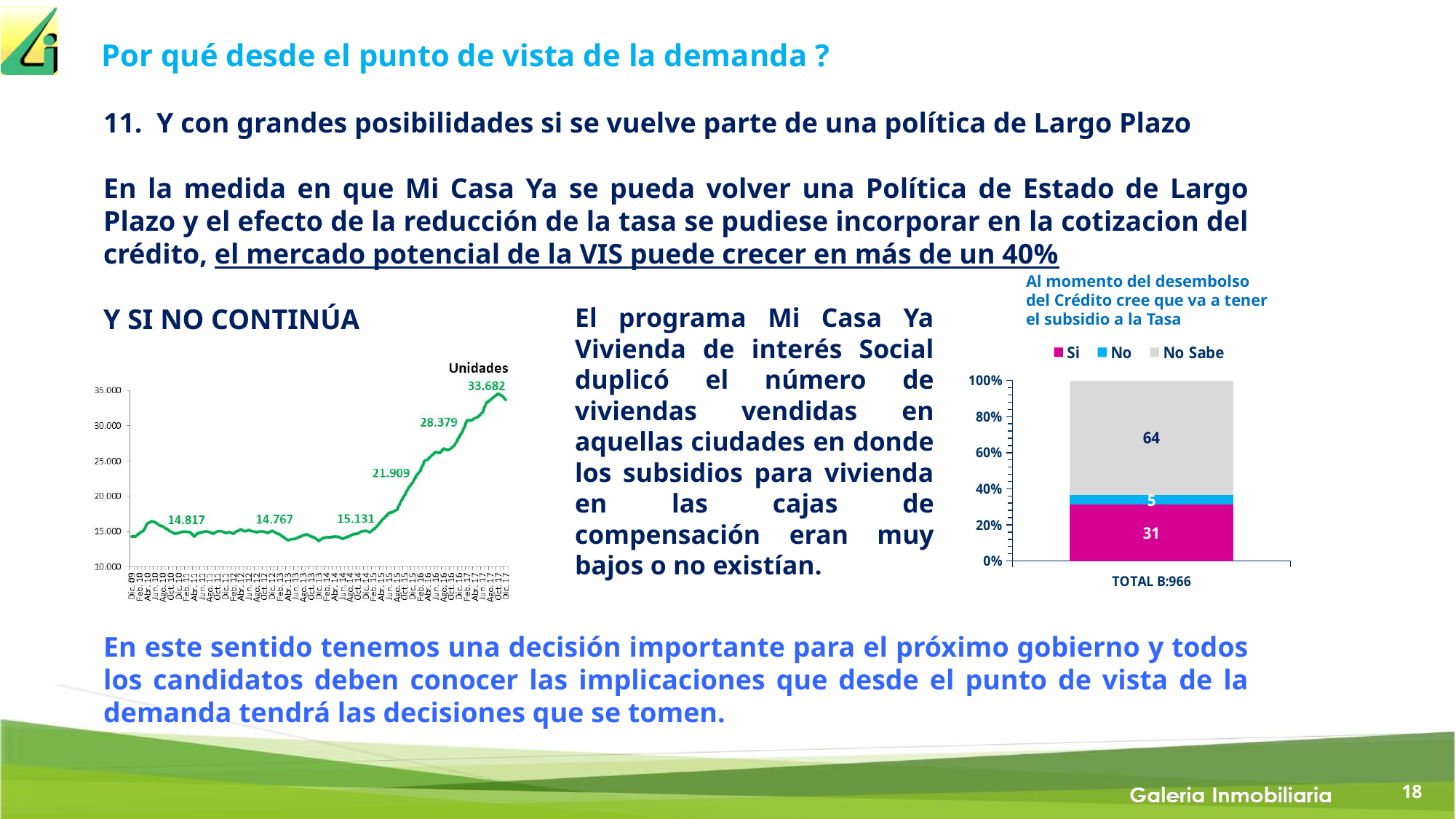
On the "Unidades" line chart, does the series rise or fall over the final years of the x axis? Rise On the stacked bar chart on the right, which response has the smallest share? No On the stacked bar chart on the right, which response has the largest share? No Sabe On the stacked bar chart on the right, what is the difference between the "No Sabe" value and the "Si" value? 33 On the stacked bar chart on the right, what is the value for "No"? 5 On the "Unidades" line chart, what is the difference between the labelled values 28.379 and 21.909? 6.470 On the stacked bar chart on the right, what is the value for "No Sabe"? 64 On the stacked bar chart on the right, what is the total of the three segments? 100 On the stacked bar chart on the right, what is the value for "Si"? 31 On the "Unidades" line chart, what is the last labelled value at the end of the series? 33.682 What kind of chart is the "Unidades" chart on the left? Line chart On the stacked bar chart on the right, how many series does the legend list? 3